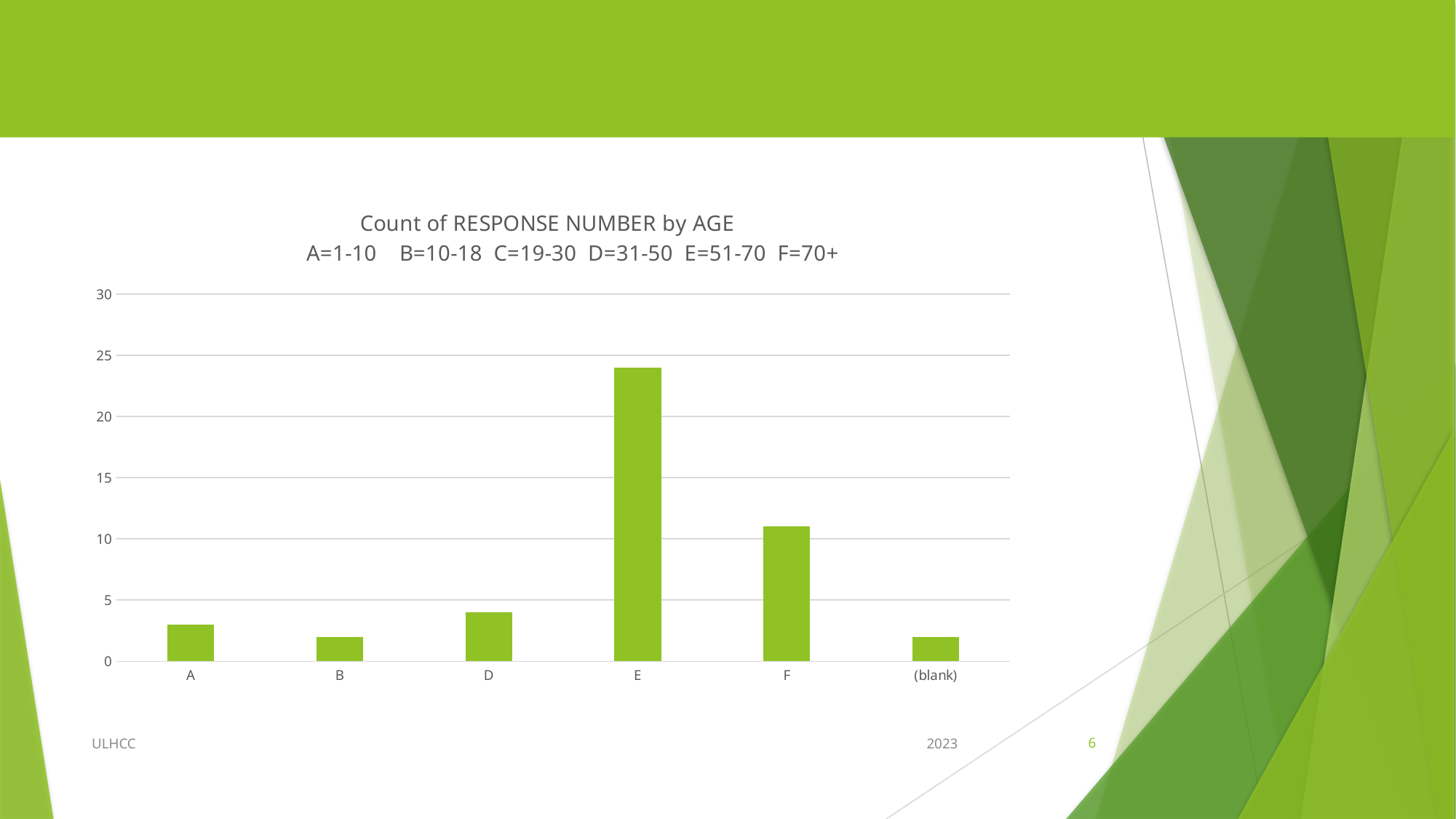
What kind of chart is shown on the slide? bar chart What is the title of the chart? Count of RESPONSE NUMBER by AGE Which is larger, the value for E or the value for F? E Is the value for E greater or less than 20? greater Is the value for F greater or less than 15? less Is the value for D greater or less than 5? less Which category has the highest count? E Which is larger, the value for F or the value for A? F How many categories are shown on the x axis of the chart? 6